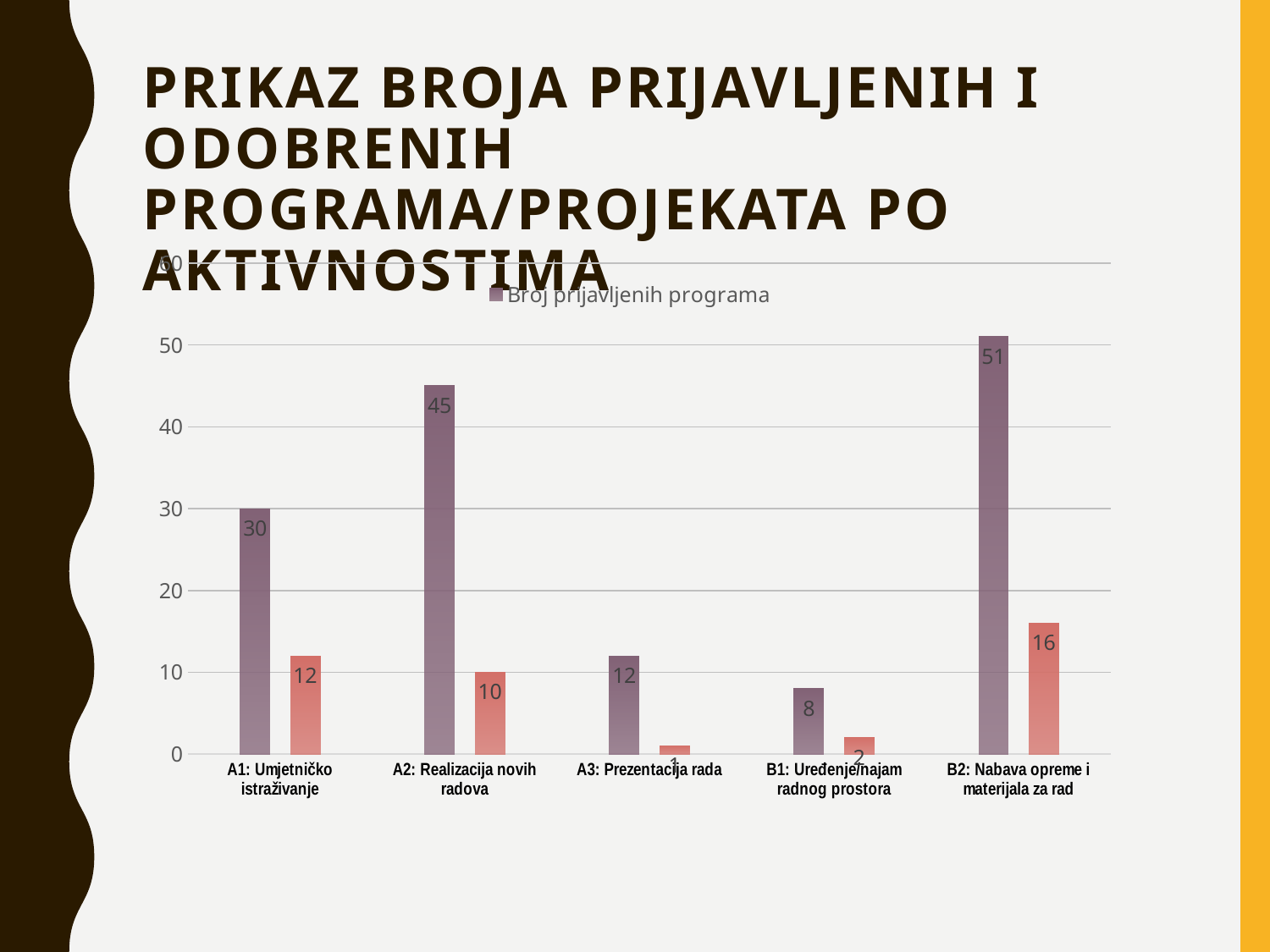
Which category has the highest value for 'Broj prijavljenih programa'? B2: Nabava opreme i materijala za rad What is the value of the red bar for 'B2: Nabava opreme i materijala za rad'? 16 Which category has the lowest value for 'Broj prijavljenih programa'? B1: Uređenje/najam radnog prostora Is the value of 'Broj prijavljenih programa' for 'B2: Nabava opreme i materijala za rad' greater or less than 50? greater What is the value of 'Broj prijavljenih programa' for 'A2: Realizacija novih radova'? 45 What is the difference between 'Broj prijavljenih programa' and the red bar for 'A1: Umjetničko istraživanje'? 18 What is the value of 'Broj prijavljenih programa' for 'B1: Uređenje/najam radnog prostora'? 8 What is the value of the red bar for 'A3: Prezentacija rada'? 1 What kind of chart is shown on the slide? bar chart Which is larger: the red bar for 'A1: Umjetničko istraživanje' or the red bar for 'A2: Realizacija novih radova'? A1: Umjetničko istraživanje What colour are the bars for the series 'Broj prijavljenih programa'? purple How many categories are shown on the x axis? 5